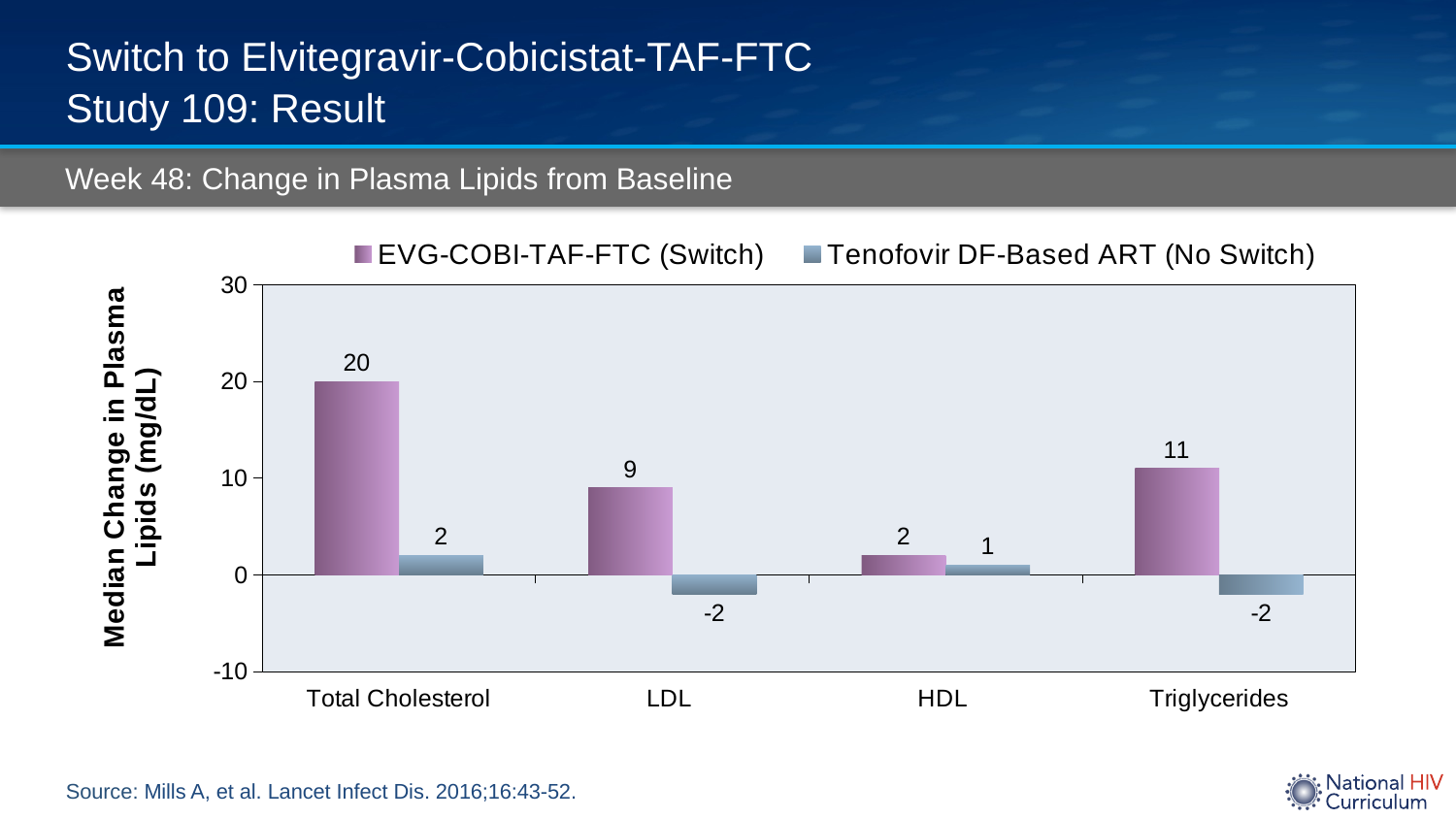
What is the median change in triglycerides for the EVG-COBI-TAF-FTC (Switch) group? 11 Which group has the larger median change in LDL, EVG-COBI-TAF-FTC (Switch) or Tenofovir DF-Based ART (No Switch)? EVG-COBI-TAF-FTC (Switch) What kind of chart is shown on the slide? Bar chart What is the difference between the Switch and No Switch values for triglycerides? 13 How many series does the legend list? 2 What is the difference between the Switch and No Switch values for total cholesterol? 18 How many lipid categories are shown on the x axis? 4 Which lipid category has the lowest value for the EVG-COBI-TAF-FTC (Switch) group? HDL What is the median change in LDL for the Tenofovir DF-Based ART (No Switch) group? -2 Which lipid category has the highest value for the EVG-COBI-TAF-FTC (Switch) group? Total Cholesterol What is the median change in total cholesterol for the EVG-COBI-TAF-FTC (Switch) group? 20 What is the median change in HDL for the Tenofovir DF-Based ART (No Switch) group? 1